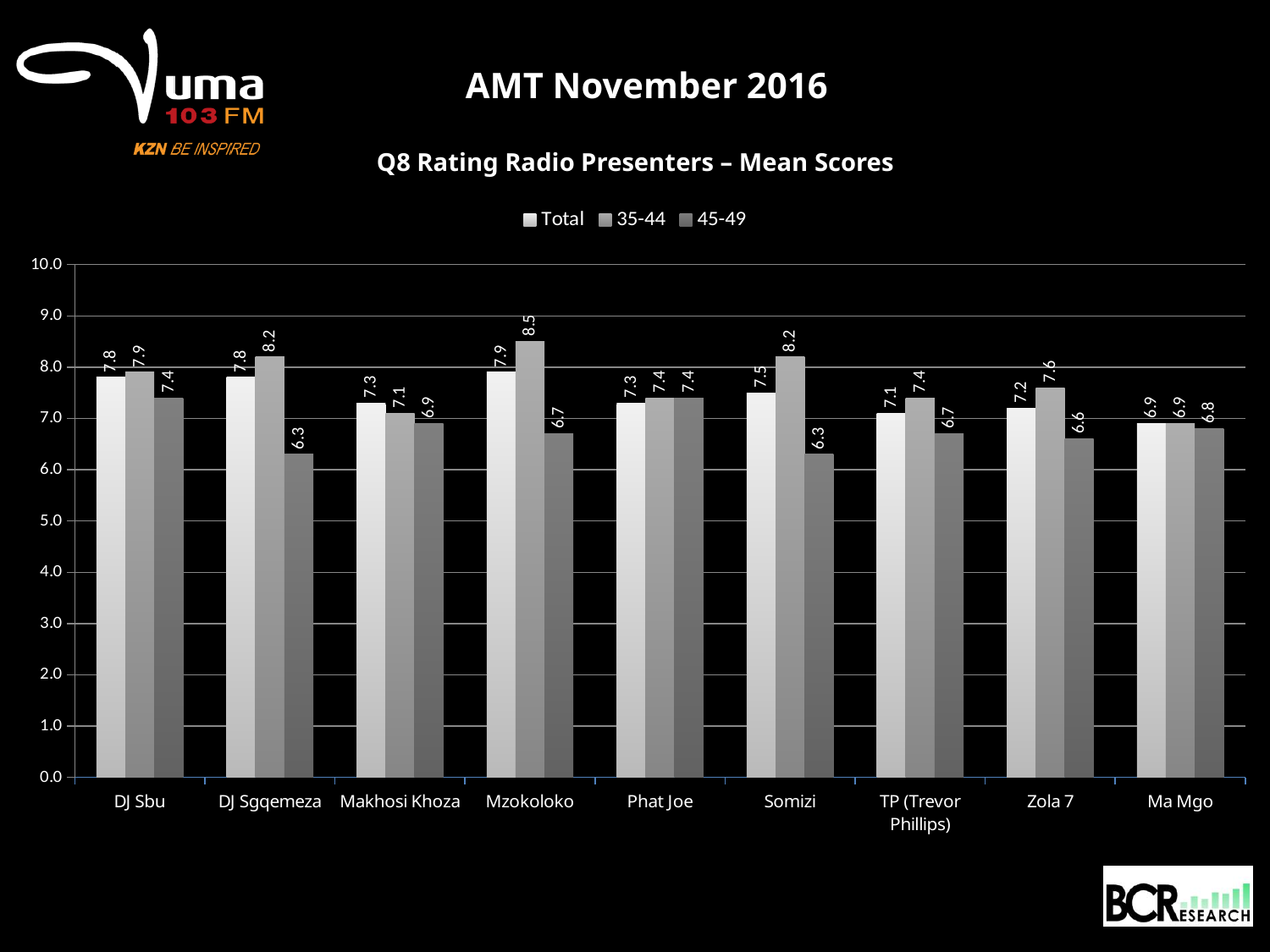
What is the Total mean score for Mzokoloko? 7.9 How many series does the legend list? 3 What is the difference between the 35-44 and 45-49 mean scores for Mzokoloko? 1.8 What is the 45-49 mean score for DJ Sgqemeza? 6.3 How many presenters are shown on the x axis? 9 Which is larger for Somizi: the Total score or the 35-44 score? 35-44 What is the 35-44 mean score for Somizi? 8.2 Which presenter has the highest 35-44 mean score? Mzokoloko What kind of chart is shown on the slide? Bar chart Which presenter has the highest Total mean score? Mzokoloko Which presenter has the lowest Total mean score? Ma Mgo What is the title of the chart? Q8 Rating Radio Presenters – Mean Scores